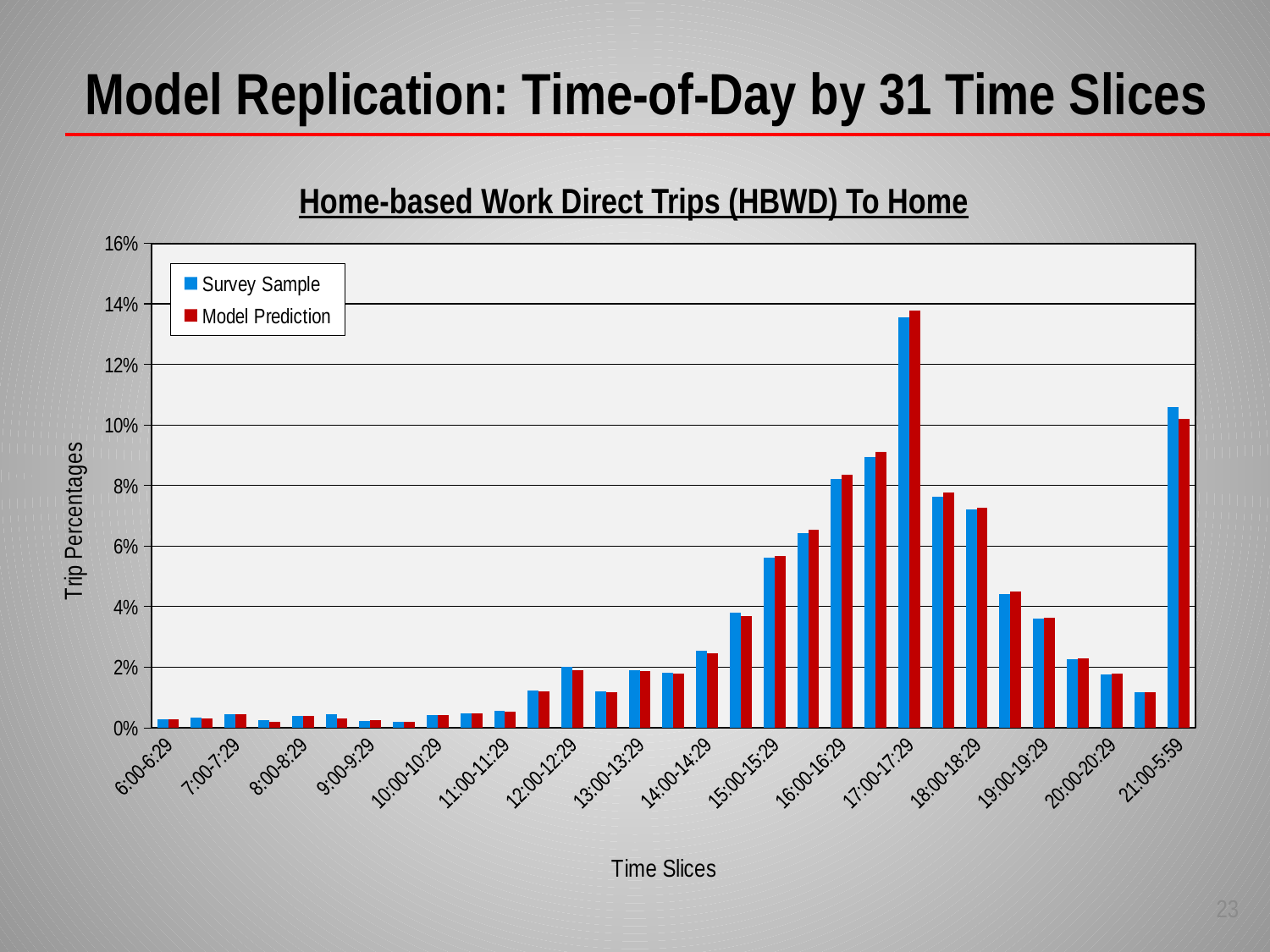
What are the two series named in the legend? Survey Sample and Model Prediction Do the Survey Sample values rise or fall from 12:00-12:29 to 17:00-17:29? rise What is the title of the chart? Home-based Work Direct Trips (HBWD) To Home Is the Survey Sample value for 21:00-5:59 greater or less than 10%? greater How many series does the legend list? 2 Is the Survey Sample value for 15:00-15:29 greater or less than 6%? less Is the Survey Sample value for 17:00-17:29 greater or less than 12%? greater Which time slice has the highest Model Prediction value? 17:00-17:29 Which time slice has the highest Survey Sample value? 17:00-17:29 What kind of chart is shown on the slide? bar chart At 21:00-5:59, which is larger, the Survey Sample value or the Model Prediction value? Survey Sample